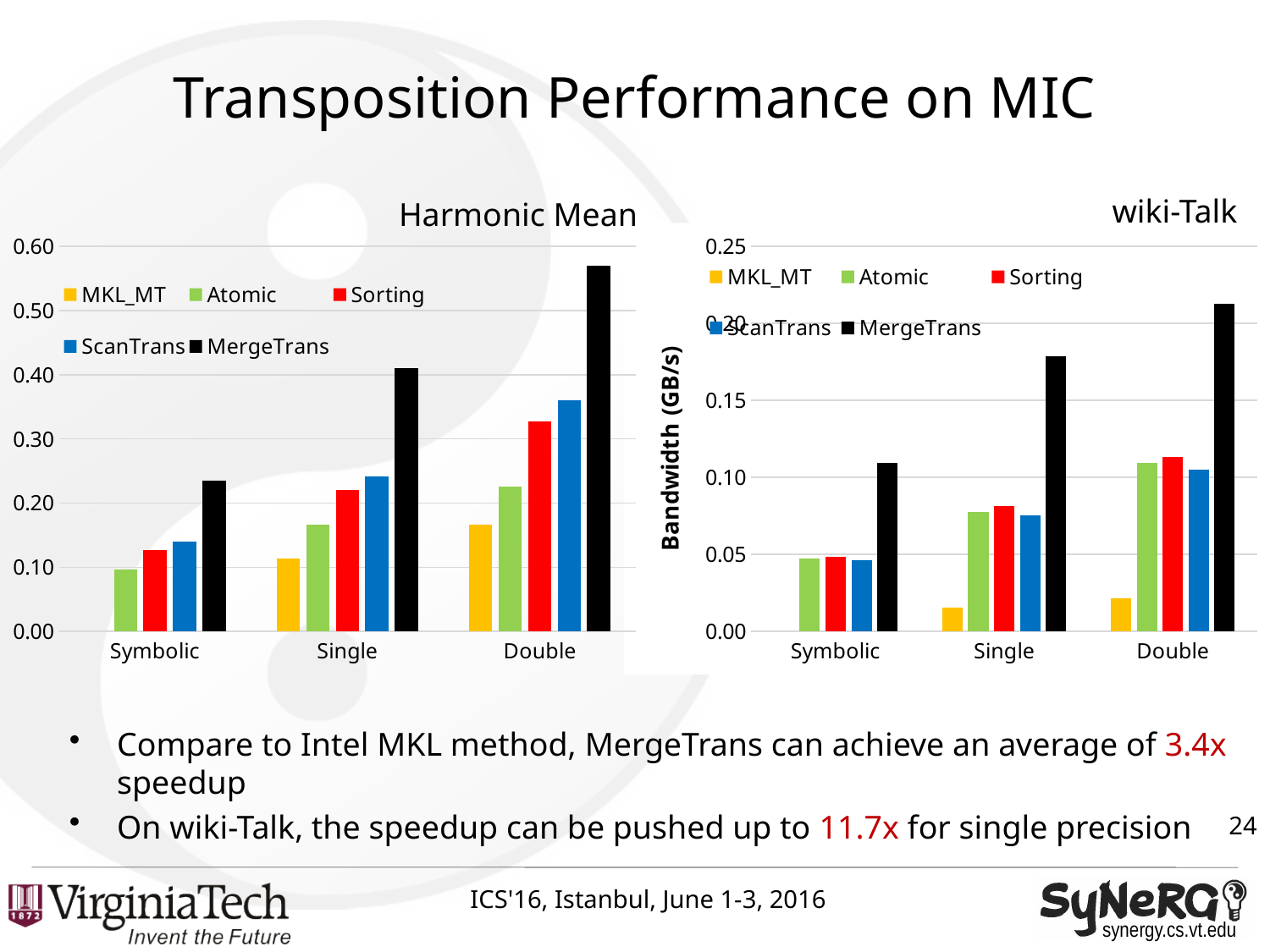
How many series does the legend of the wiki-Talk chart list? 5 In the Harmonic Mean chart, is the MergeTrans value for Double greater or less than 0.50? greater How many categories are shown on the x axis of the Harmonic Mean chart? 3 In the wiki-Talk chart, do the MergeTrans values rise or fall from Symbolic to Double? rise In the wiki-Talk chart, which series has the lowest bar for Single? MKL_MT What kind of chart is the Harmonic Mean chart? bar chart In the wiki-Talk chart, is the MergeTrans value for Double greater or less than 0.20? greater What is the y-axis title of the wiki-Talk chart? Bandwidth (GB/s) In the Harmonic Mean chart, which series has the highest bar for Double? MergeTrans In the wiki-Talk chart, is the MKL_MT value for Single greater or less than 0.05? less In the Harmonic Mean chart, which is larger for Double: ScanTrans or Sorting? ScanTrans